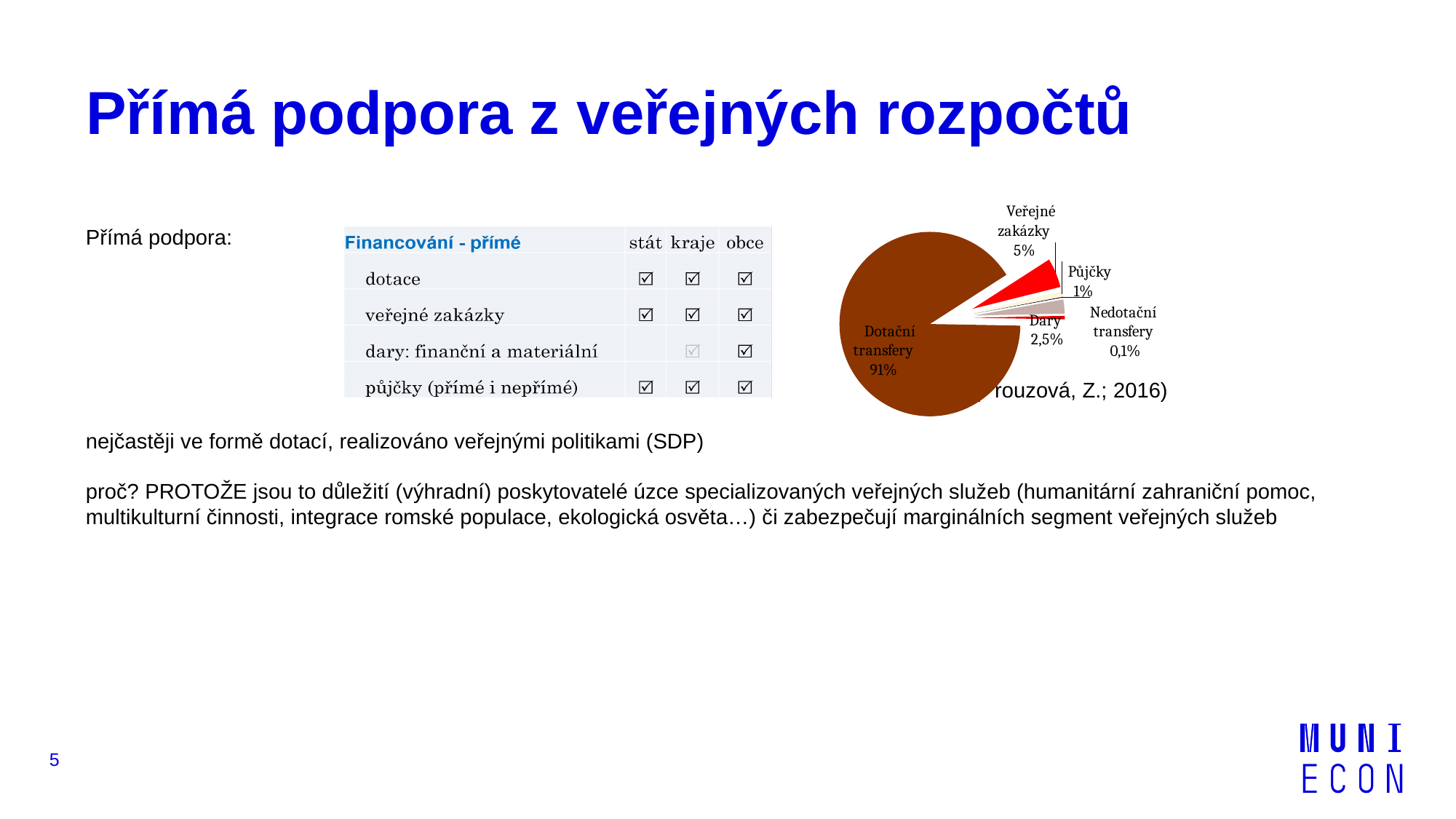
What share of the pie does Nedotační transfery have? 0,1% What share of the pie does Dotační transfery have? 91% Which is larger in the pie chart, Půjčky or Dary? Dary Which slice of the pie chart is the largest? Dotační transfery What colour is the Dotační transfery slice in the pie chart? brown What share of the pie does Půjčky have? 1% What is the difference in percentage points between Veřejné zakázky and Dary? 2,5% Which slice of the pie chart is the smallest? Nedotační transfery How many slices does the pie chart have? 6 What kind of chart is shown on the slide? pie chart